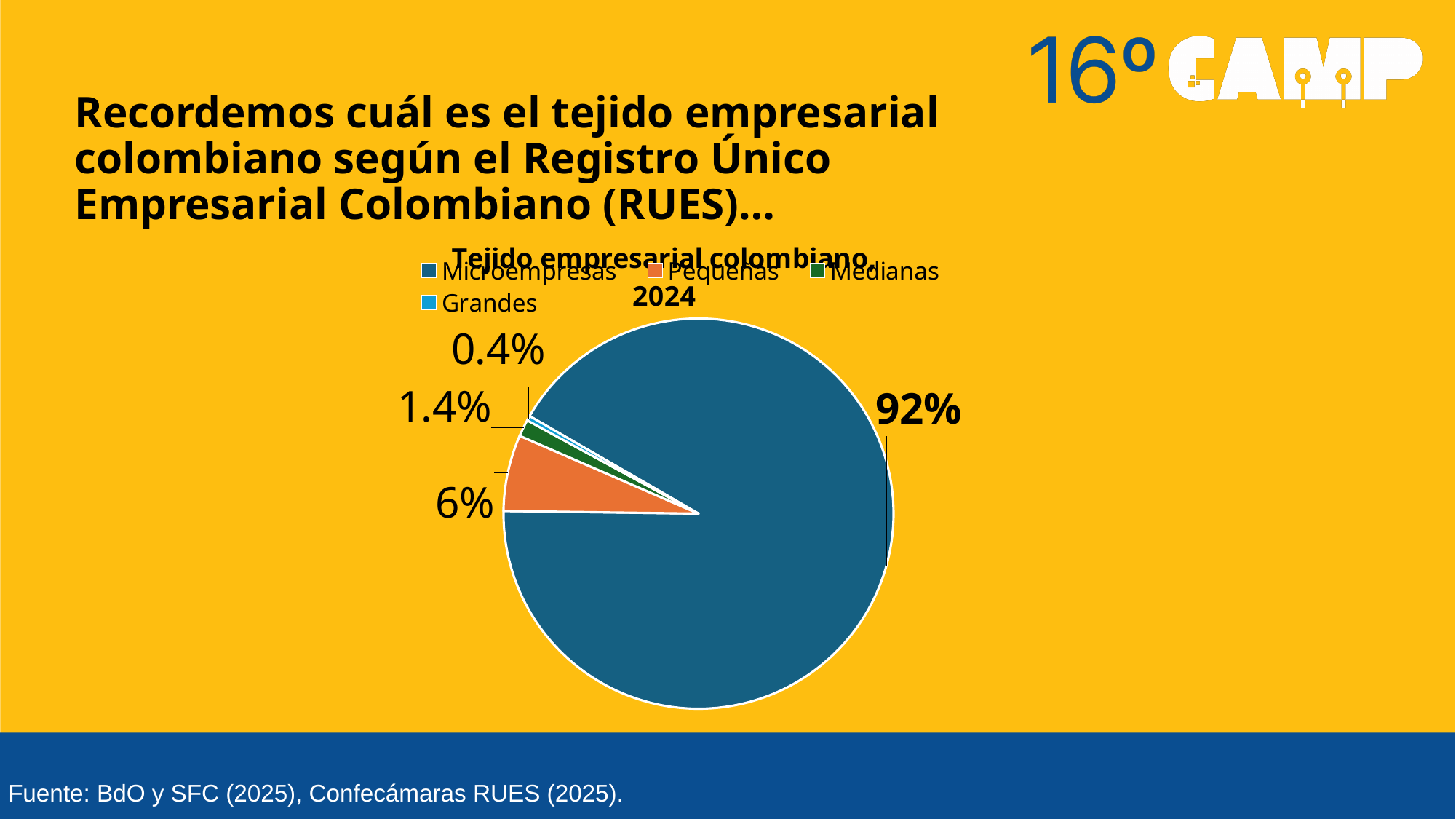
What is the difference in percentage points between Microempresas and Pequeñas? 86 What percentage of the pie corresponds to Pequeñas? 6% Which category has the largest share of the pie? Microempresas What type of chart is shown on the slide? pie chart Which category has the smallest share of the pie? Grandes How many categories does the legend list? 4 What percentage of the pie corresponds to Grandes? 0.4% What colour is the slice for Pequeñas? orange Which is larger, the share for Medianas or the share for Grandes? Medianas What is the title of the pie chart? Tejido empresarial colombiano, 2024 What percentage of the pie corresponds to Microempresas? 92% What percentage of the pie corresponds to Medianas? 1.4%